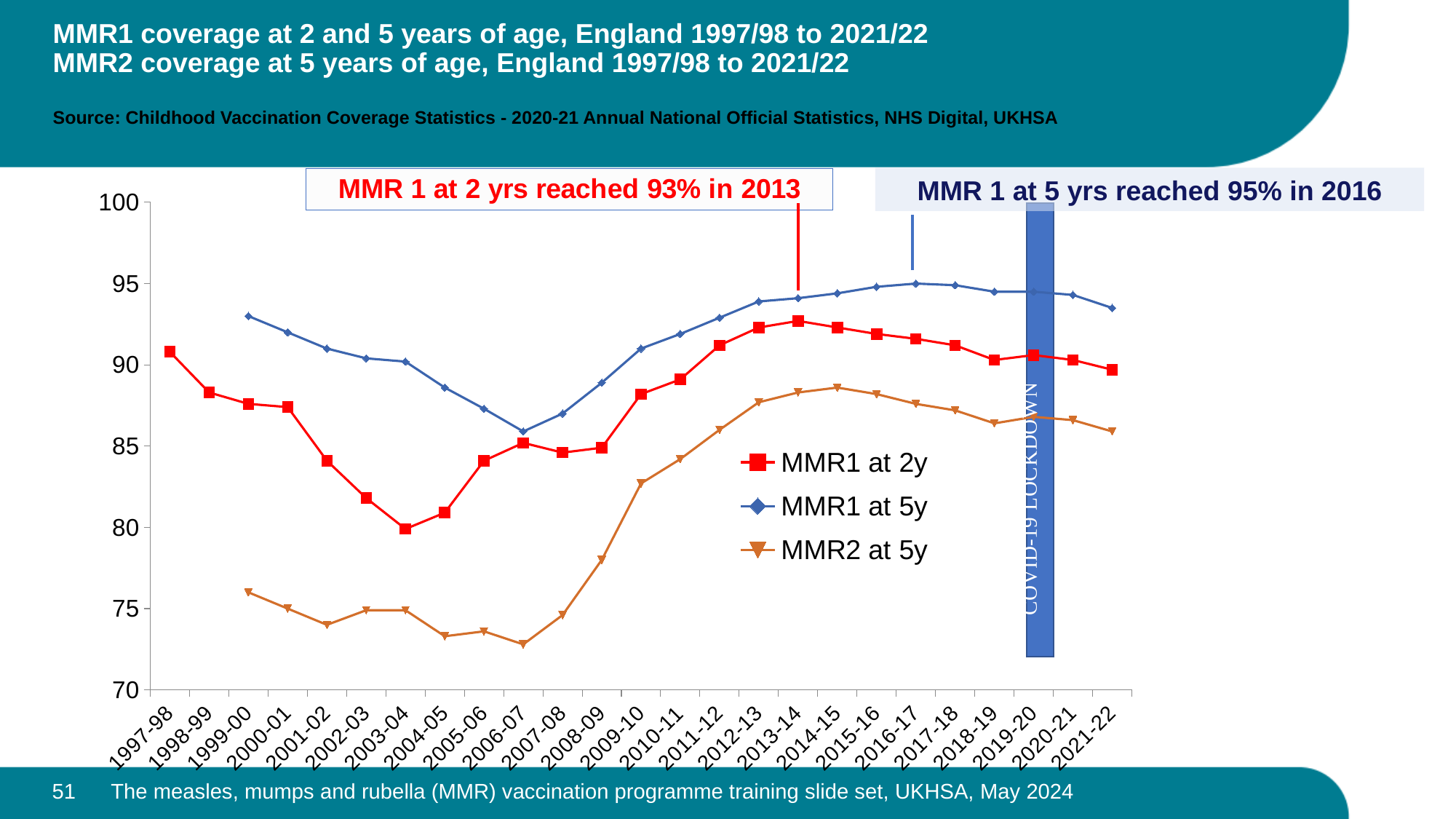
Is the value for MMR1 at 2y in 2013-14 greater or less than 90? greater According to the annotation, what coverage did MMR1 at 5 years reach in 2016? 95% What is the label on the blue vertical bar near 2019-20? COVID-19 LOCKDOWN How many years are shown along the x axis? 25 In which year is the MMR2 at 5y series at its lowest? 2006-07 Does the MMR1 at 2y series rise or fall from 1997-98 to 2003-04? Fall Is the value for MMR2 at 5y in 2006-07 greater or less than 75? less According to the annotation, what coverage did MMR1 at 2 years reach in 2013? 93% How many series does the legend list? 3 In 2009-10, which is larger: MMR1 at 5y or MMR2 at 5y? MMR1 at 5y What type of chart is shown on the slide? Line chart In which year is the MMR1 at 2y series at its lowest? 2003-04